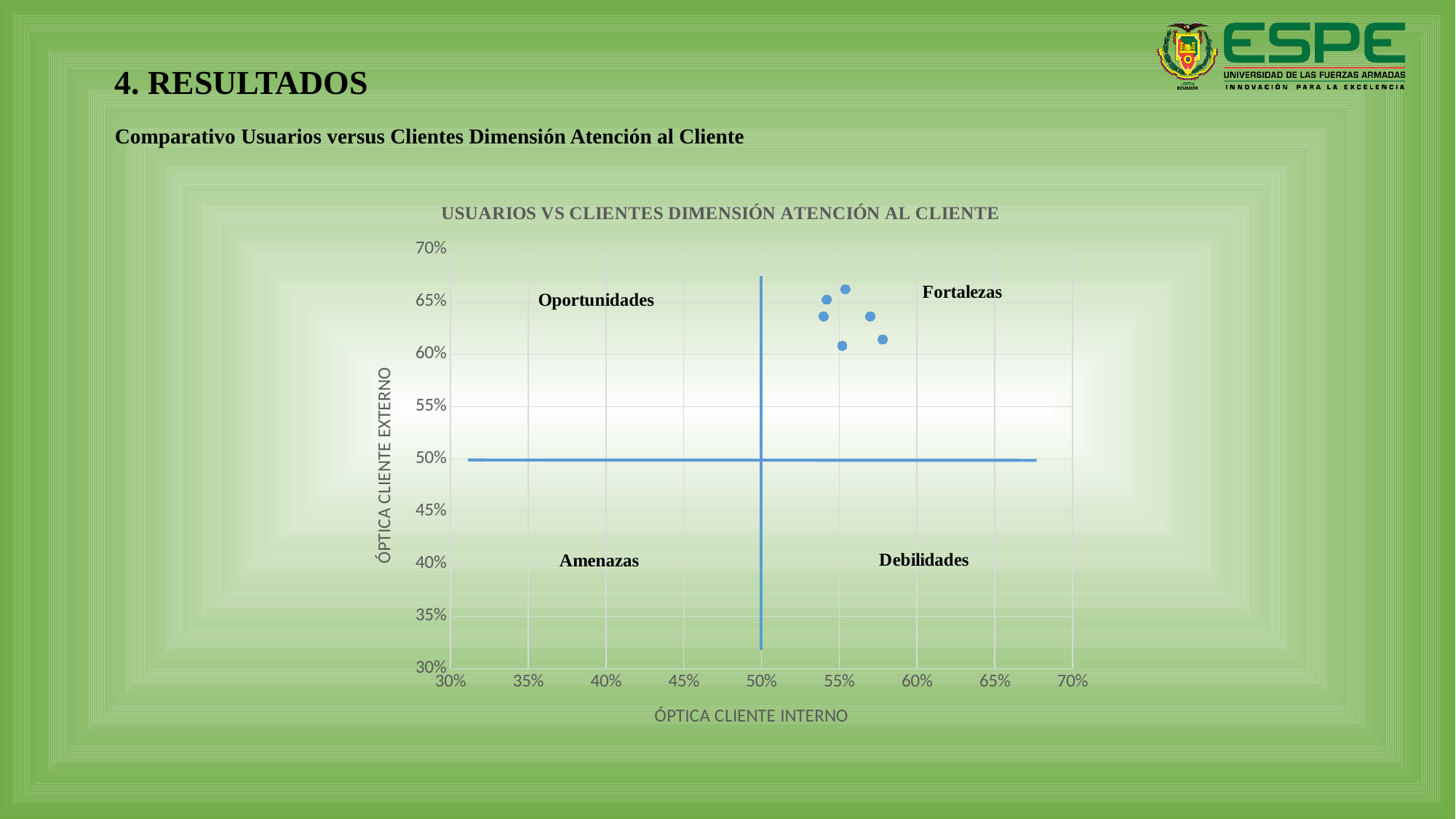
What is the label of the horizontal axis? ÓPTICA CLIENTE INTERNO What kind of chart is shown on the slide? scatter chart What is the title of the chart? USUARIOS VS CLIENTES DIMENSIÓN ATENCIÓN AL CLIENTE Are the plotted points' values on the ÓPTICA CLIENTE INTERNO axis greater or less than 50%? greater What is the label of the vertical axis? ÓPTICA CLIENTE EXTERNO Are the plotted points' values on the ÓPTICA CLIENTE EXTERNO axis greater or less than 60%? greater Are the plotted points' values on the ÓPTICA CLIENTE EXTERNO axis greater or less than 70%? less How many data points are plotted on the chart? 6 How many points are plotted in the Amenazas quadrant? 0